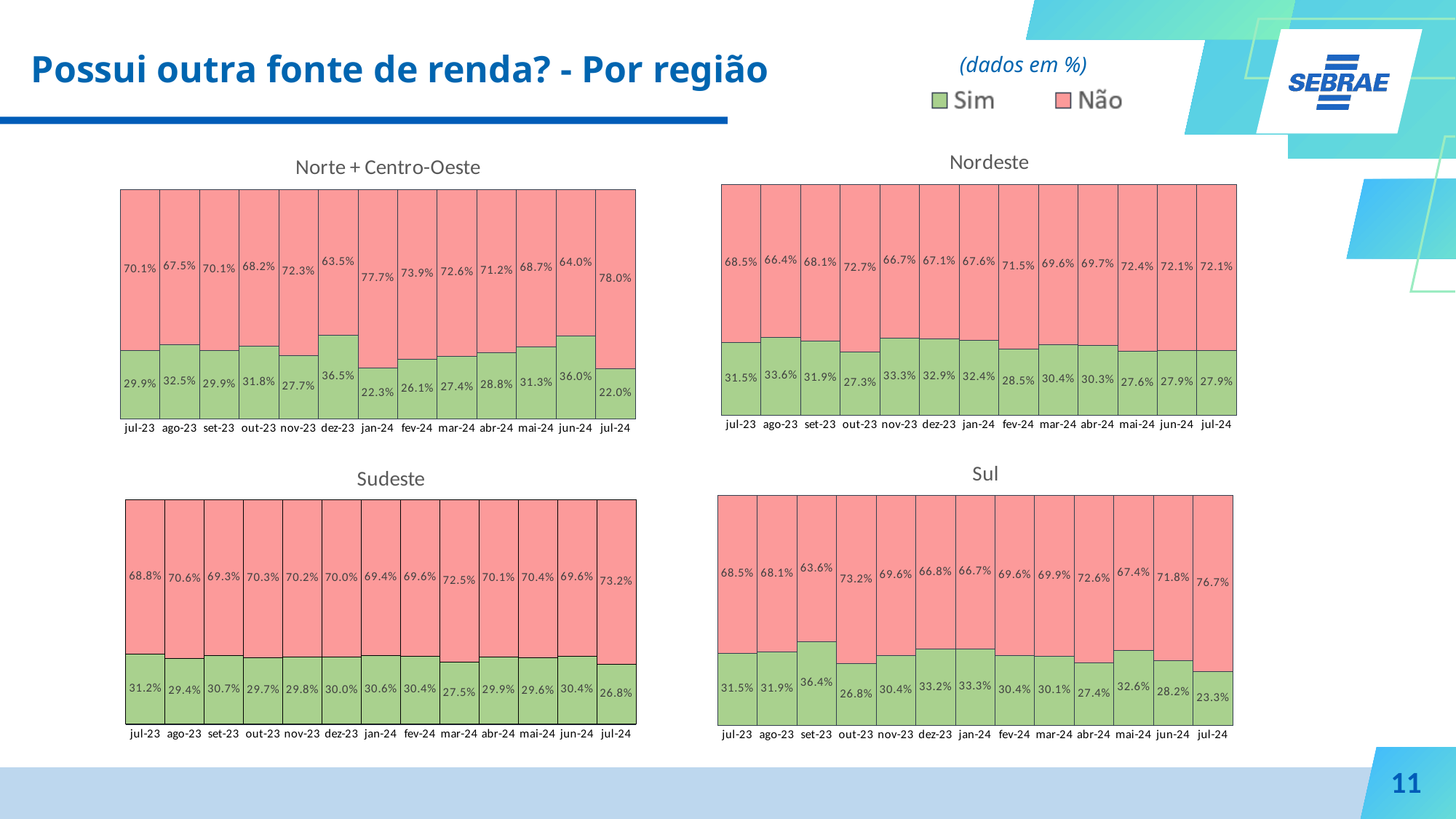
In the Sul chart, what is the value of Não for jul-24? 76.7% In the Nordeste chart, which month has the highest Sim value? ago-23 In the Norte + Centro-Oeste chart, which month has the lowest Sim value? jul-24 In the Sudeste chart, is the Sim value for jul-23 larger or smaller than the Sim value for jul-24? larger In the Norte + Centro-Oeste chart, what is the value of Sim for dez-23? 36.5% In the Nordeste chart, what is the value of Não for out-23? 72.7% In the Sudeste chart, what is the value of Sim for mar-24? 27.5% How many series does the legend list? 2 In the Sul chart, which month has the highest Sim value? set-23 How many months are shown on the x axis of the Sul chart? 13 What kind of chart is the Nordeste chart? Stacked bar chart In the Norte + Centro-Oeste chart, what is the difference between Não and Sim for jul-24? 56.0 percentage points